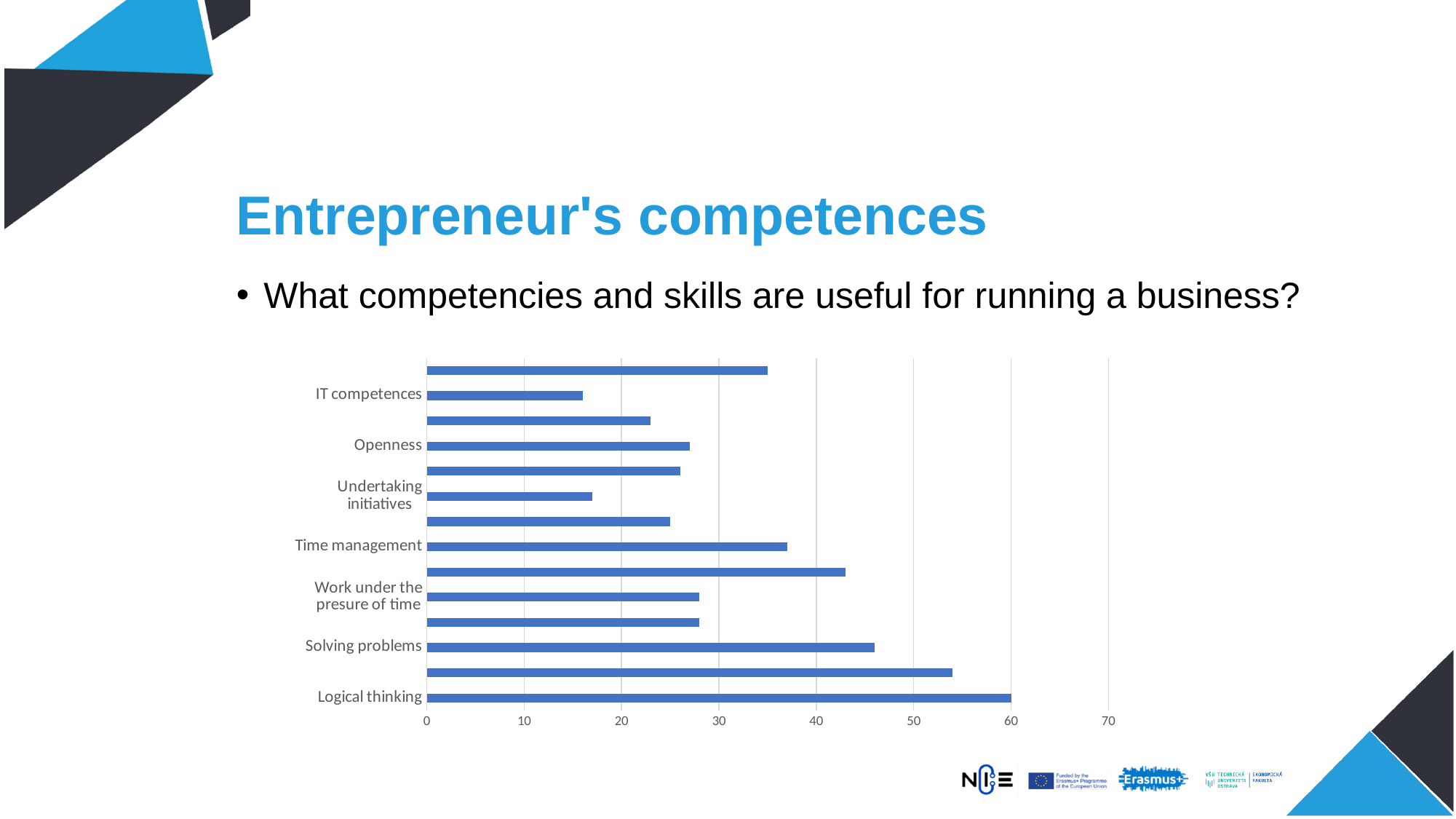
Is the value for Undertaking initiatives greater or less than 20? less Is the value for IT competences greater or less than 20? less Is the value for Solving problems greater or less than 40? greater Which labelled category has the longest bar? Logical thinking How many category labels are shown on the vertical axis of the chart? 7 What colour are the bars in the chart? blue Which is larger, the value for Solving problems or the value for Time management? Solving problems Which is larger, the value for Logical thinking or the value for Work under the presure of time? Logical thinking What kind of chart is shown on the slide? bar chart What is the value for Logical thinking? 60